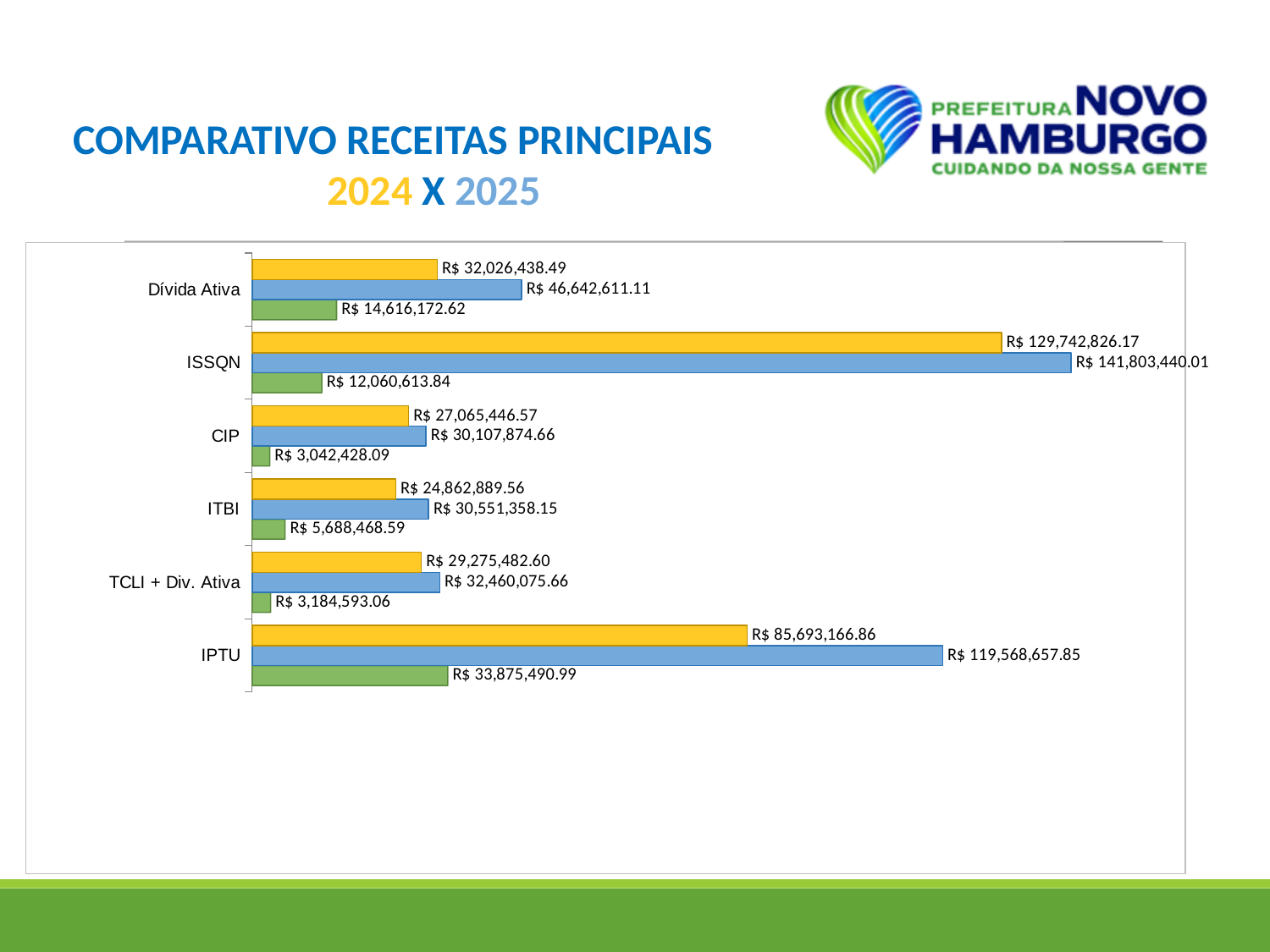
What is the value of the yellow bar for ISSQN? R$ 129,742,826.17 Which category has the highest blue bar? ISSQN Which category has the lowest green bar? CIP What is the difference between the blue bar and the yellow bar for IPTU? R$ 33,875,490.99 What is the difference between the blue bar and the yellow bar for ITBI? R$ 5,688,468.59 What kind of chart is shown on the slide? bar chart What is the title of the slide above the chart? COMPARATIVO RECEITAS PRINCIPAIS 2024 X 2025 Which is larger for CIP: the yellow bar or the blue bar? the blue bar How many categories are shown on the chart? 6 What is the value of the green bar for Dívida Ativa? R$ 14,616,172.62 What is the value of the blue bar for IPTU? R$ 119,568,657.85 What is the value of the blue bar for TCLI + Div. Ativa? R$ 32,460,075.66